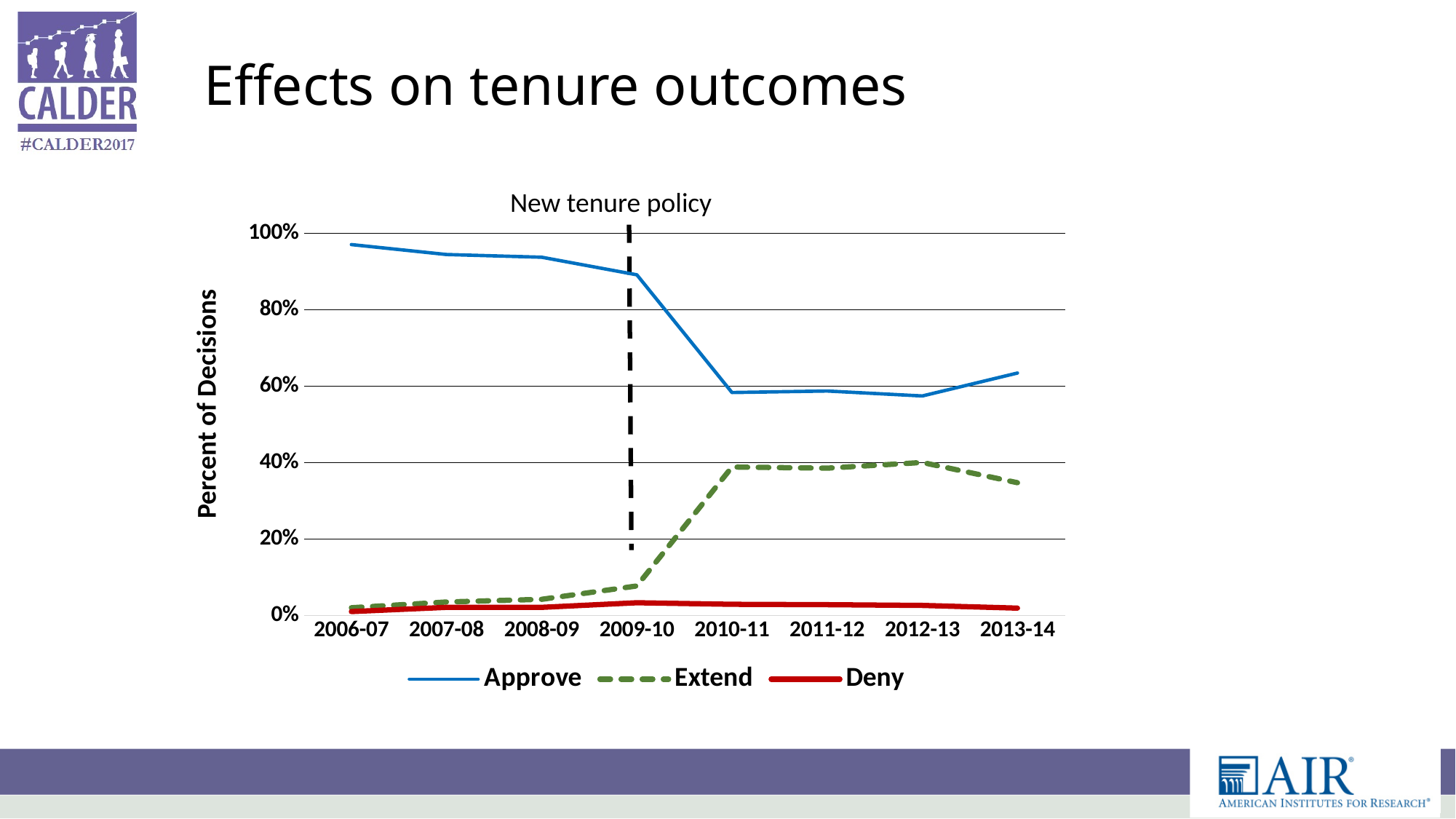
Is the value for Extend in 2012-13 greater or less than 20%? greater Is the value for Approve in 2006-07 greater or less than 80%? greater Which series has the highest value in 2013-14? Approve Which series has the lowest value in 2011-12? Deny What label is shown on the y axis? Percent of Decisions Is the value for Extend in 2008-09 greater or less than 20%? less Does the Approve series rise or fall from 2006-07 to 2013-14? fall How many series does the legend list? 3 How many school years are shown on the x axis? 8 In 2010-11, which is larger: the value for Extend or the value for Deny? Extend What kind of chart is shown on the slide? line chart